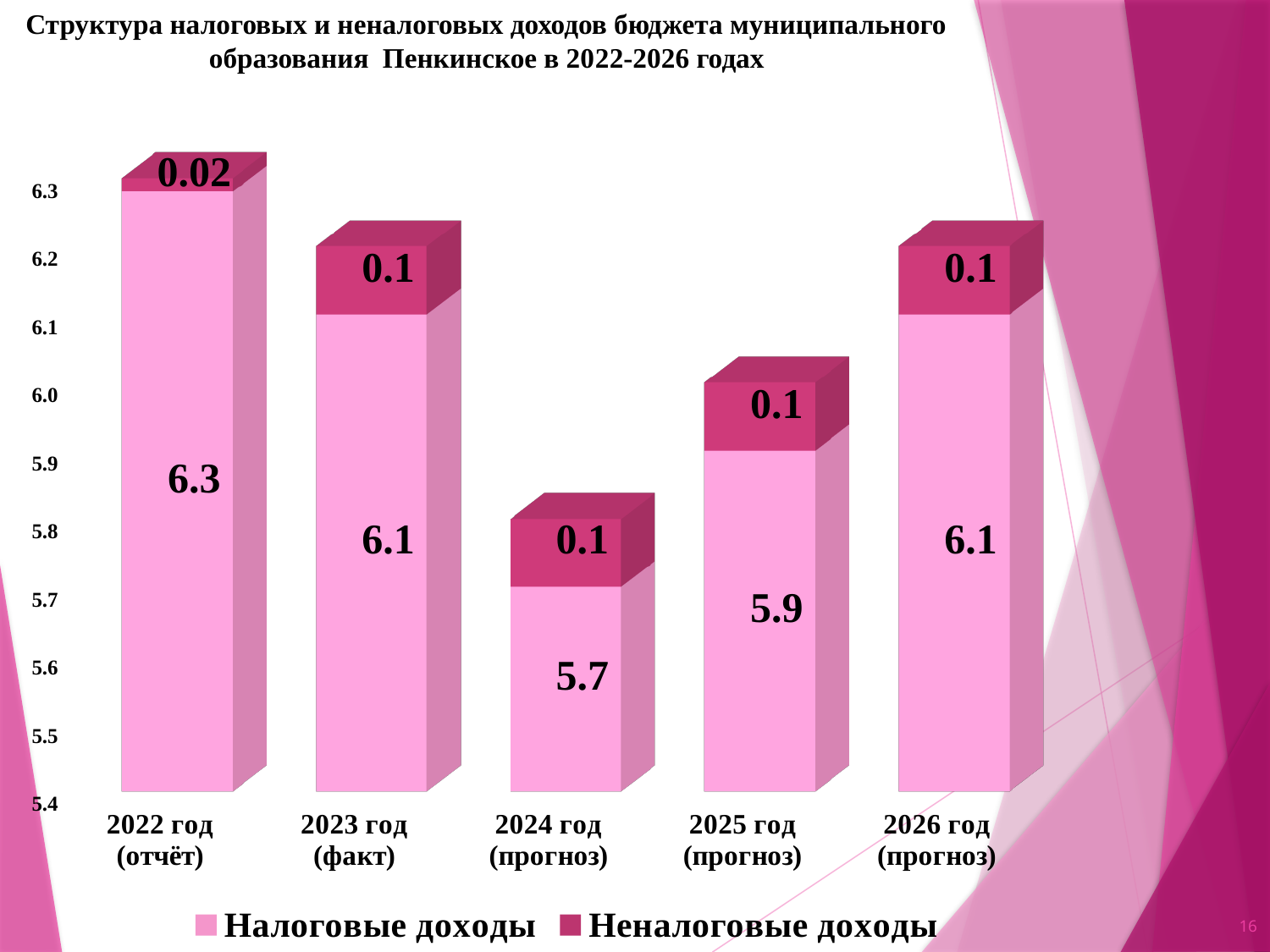
What is the value of Налоговые доходы for 2024 год (прогноз)? 5.7 What kind of chart is shown on the slide? Stacked bar chart Which year has the highest value of Налоговые доходы? 2022 год (отчёт) What is the total of the stacked bar for 2024 год (прогноз)? 5.8 What is the difference between Налоговые доходы in 2022 год (отчёт) and 2024 год (прогноз)? 0.6 Which year has the lowest value of Налоговые доходы? 2024 год (прогноз) What is the value of Налоговые доходы for 2025 год (прогноз)? 5.9 What is the value of Неналоговые доходы for 2022 год (отчёт)? 0.02 Which is larger: Налоговые доходы in 2025 год (прогноз) or in 2026 год (прогноз)? 2026 год (прогноз) What is the value of Налоговые доходы for 2022 год (отчёт)? 6.3 How many series does the legend list? 2 How many years (categories) are shown on the x axis? 5